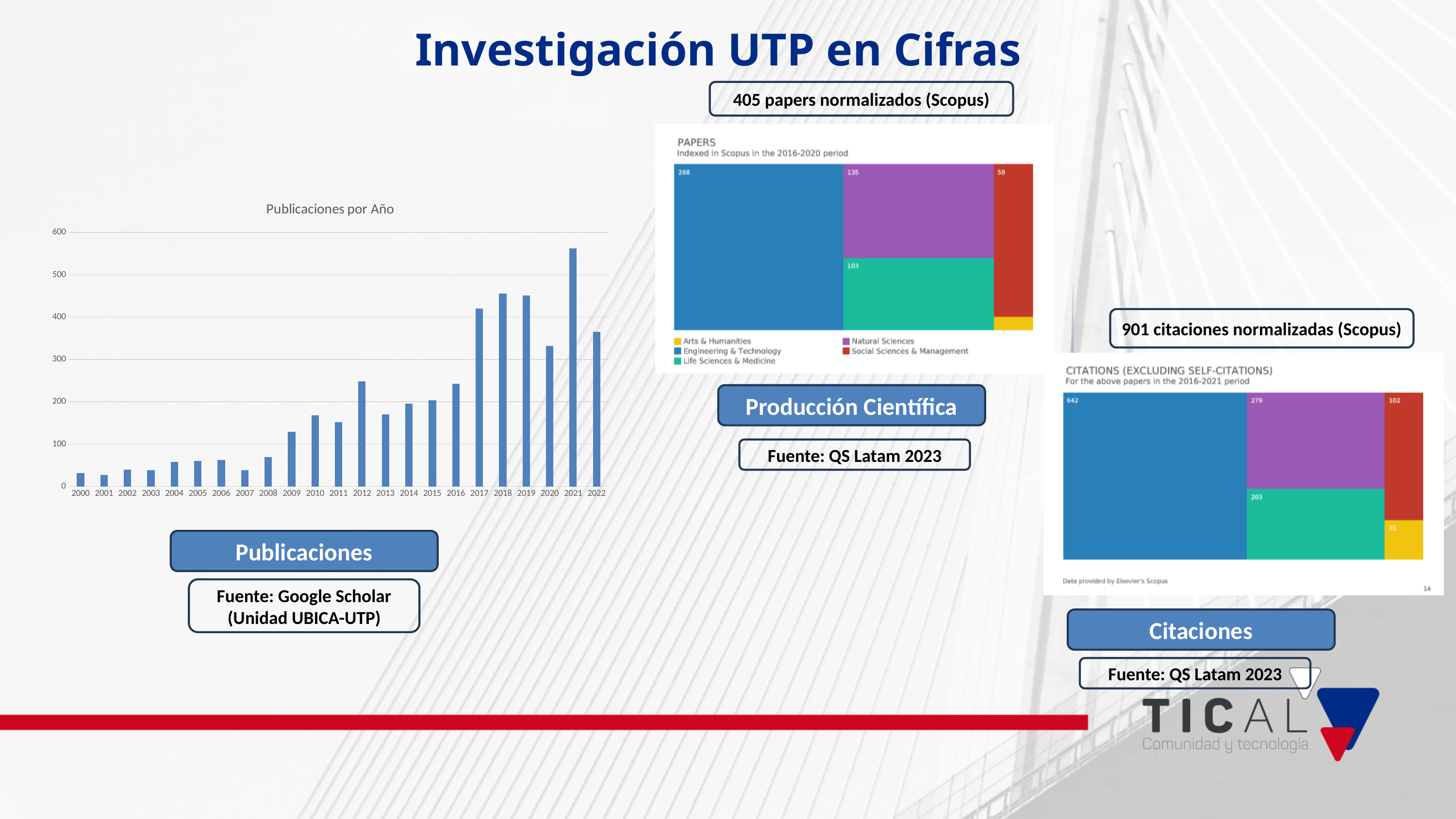
In the 'PAPERS Indexed in Scopus in the 2016-2020 period' chart, what is the difference between Engineering & Technology and Natural Sciences? 133 In the 'CITATIONS (EXCLUDING SELF-CITATIONS)' chart, what is the value of the largest block? 642 In the 'Publicaciones por Año' chart, how many years are shown on the x axis? 23 In the 'Publicaciones por Año' chart, do publications generally rise or fall from 2000 to 2021? rise In the 'Publicaciones por Año' chart, what kind of chart is used? bar chart In the 'Publicaciones por Año' chart, is the value for 2021 greater or less than 500? greater In the 'PAPERS Indexed in Scopus in the 2016-2020 period' chart, how many categories does the legend list? 5 In the 'Publicaciones por Año' chart, which year has the highest number of publications? 2021 In the 'Publicaciones por Año' chart, is the value for 2008 greater or less than 100? less In the 'Publicaciones por Año' chart, is the value for 2020 greater or less than 300? greater In the 'CITATIONS (EXCLUDING SELF-CITATIONS)' chart, which is larger, the purple block (279) or the green block (203)? the purple block (279) In the 'PAPERS Indexed in Scopus in the 2016-2020 period' chart, how many papers are in Engineering & Technology? 268